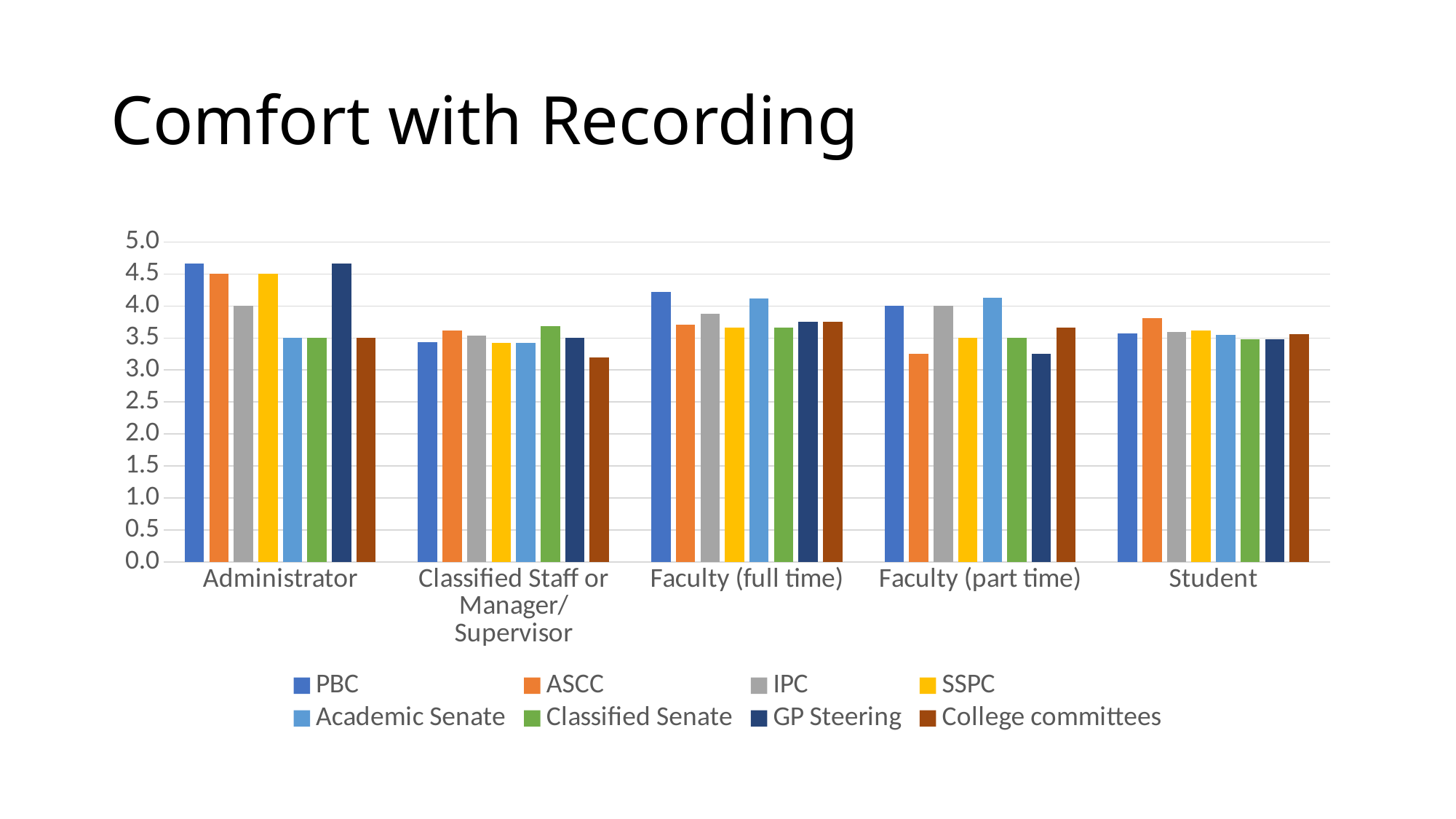
Which series has the highest value in the Student category? ASCC How many categories are shown along the x axis? 5 What kind of chart is shown on the slide? bar chart Is the value for PBC in the Administrator category greater or less than 4.0? greater Is the value for ASCC in the Faculty (part time) category greater or less than 3.5? less Is the value for College committees in the Classified Staff or Manager/Supervisor category greater or less than 3.5? less In the Administrator category, which is larger: PBC or IPC? PBC How many series does the legend list? 8 In the Faculty (full time) category, which is larger: PBC or ASCC? PBC What is the title of the slide? Comfort with Recording Which series has the lowest value in the Classified Staff or Manager/Supervisor category? College committees